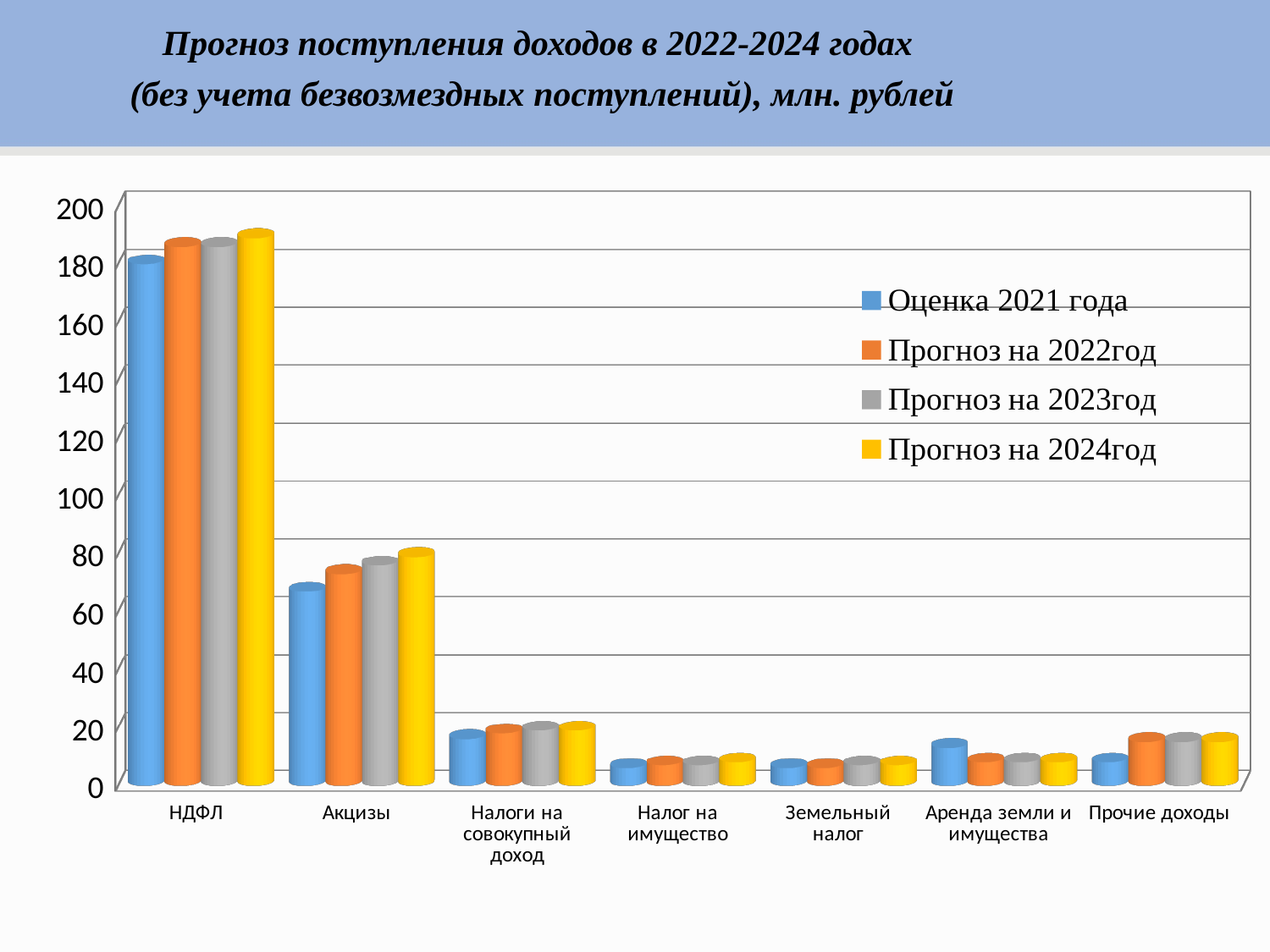
Do the values for Акцизы rise or fall from Оценка 2021 года to Прогноз на 2024год? rise Which category has the highest value for Оценка 2021 года? НДФЛ Is the value for Налоги на совокупный доход in Оценка 2021 года greater or less than 20? less For Аренда земли и имущества, which is larger: Оценка 2021 года or Прогноз на 2022год? Оценка 2021 года Is the value for НДФЛ in Оценка 2021 года greater or less than 160? greater Which category has the highest value for Прогноз на 2024год? НДФЛ How many categories are shown on the x axis? 7 How many series does the legend list? 4 What kind of chart is shown on the slide? bar chart Is the value for Акцизы in Оценка 2021 года greater or less than 60? greater Which is larger for Прогноз на 2022год: НДФЛ or Акцизы? НДФЛ